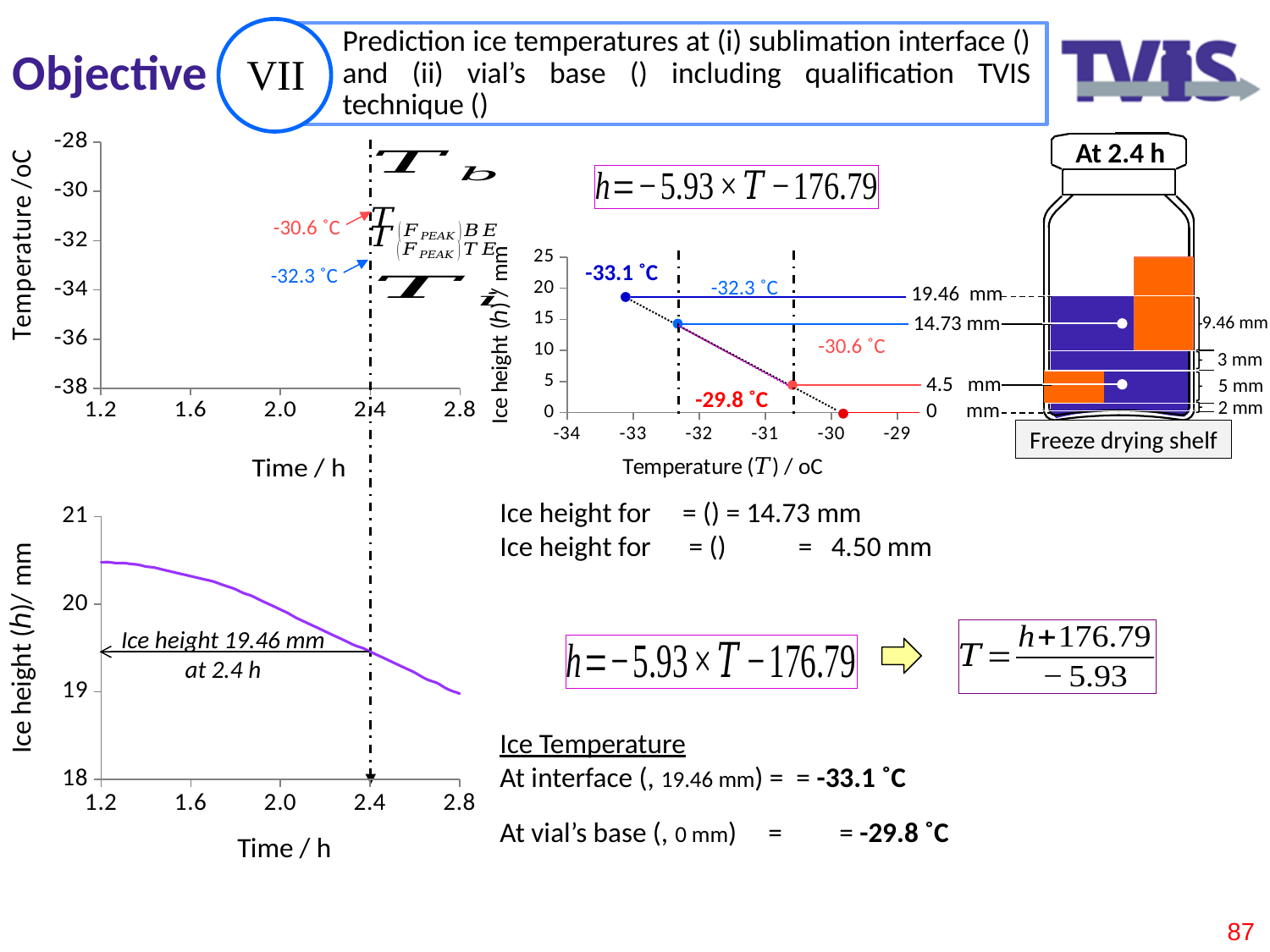
In the middle chart of ice height versus temperature, does the ice height rise or fall as temperature increases along the x axis? fall In the bottom-left chart of ice height versus time, is the ice height at 1.2 h greater or less than 20 mm? greater In the bottom-left chart of ice height versus time, what kind of chart is it? line chart In the middle chart of ice height versus temperature, how many data points are plotted? 4 In the middle chart of ice height versus temperature, what is the difference between the ice heights at -32.3 °C and -30.6 °C? 10.23 mm In the middle chart of ice height versus temperature, what temperature corresponds to an ice height of 19.46 mm? -33.1 °C In the bottom-left chart of ice height versus time, does the ice height rise or fall as time increases? fall In the bottom-left chart of ice height versus time, what is the label of the x axis? Time / h In the middle chart of ice height versus temperature, what is the ice height at -32.3 °C? 14.73 mm In the middle chart of ice height versus temperature, what is the ice height at -30.6 °C? 4.5 mm In the bottom-left chart of ice height versus time, what is the ice height at 2.4 h? 19.46 mm In the middle chart of ice height versus temperature, what temperature corresponds to an ice height of 0 mm? -29.8 °C